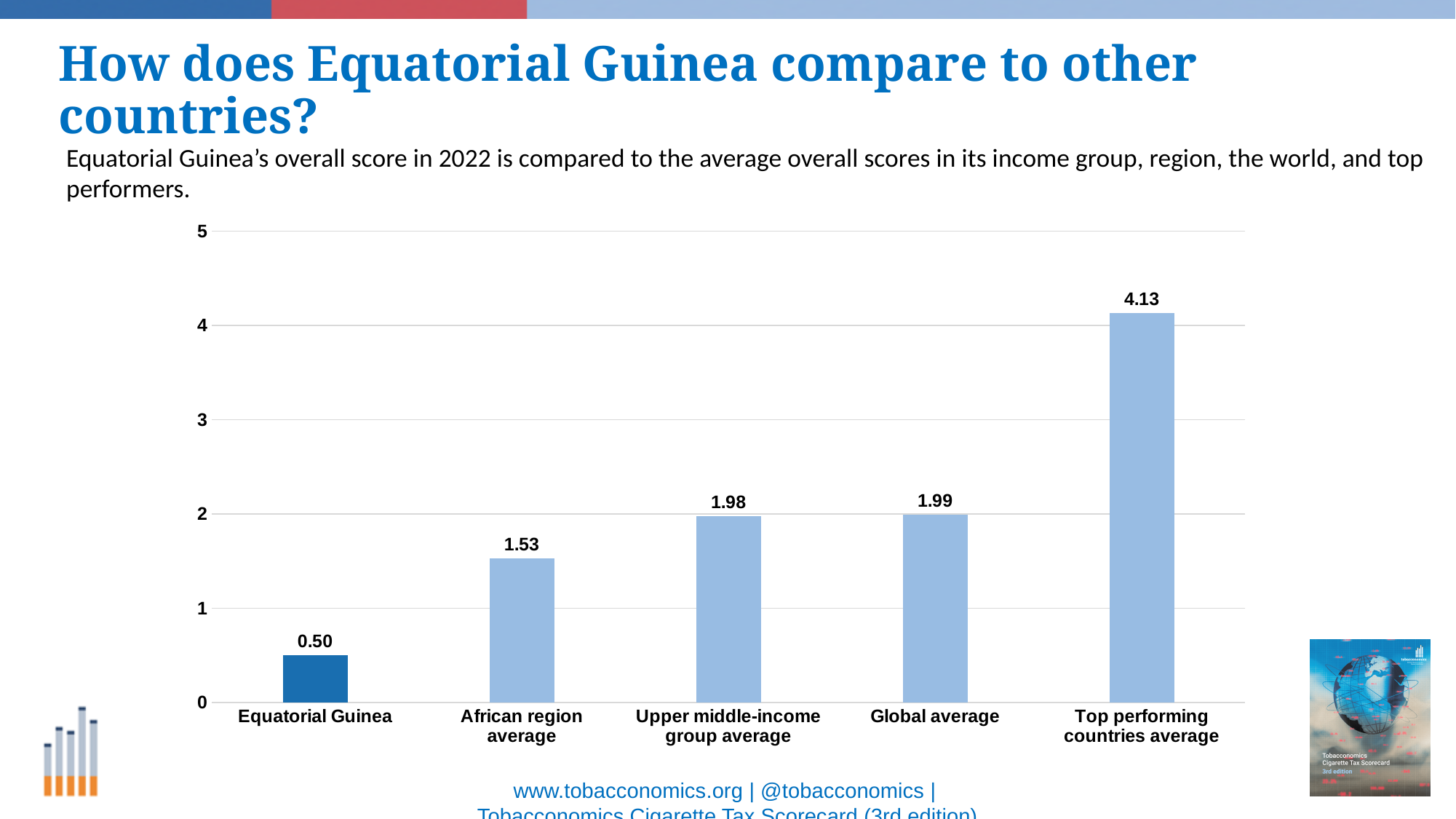
Is the value for the Top performing countries average greater or less than 4? greater How many categories are shown on the chart? 5 What is the overall score for Equatorial Guinea? 0.50 What is the value for the African region average? 1.53 Which category has the lowest value? Equatorial Guinea What is the value for the Upper middle-income group average? 1.98 What is the difference between the Top performing countries average and Equatorial Guinea's score? 3.63 Which category has the highest value? Top performing countries average What is the value for the Top performing countries average? 4.13 Which is larger, the African region average or the Global average? Global average What is the difference between the Global average and the African region average? 0.46 What kind of chart is shown on the slide? Bar chart